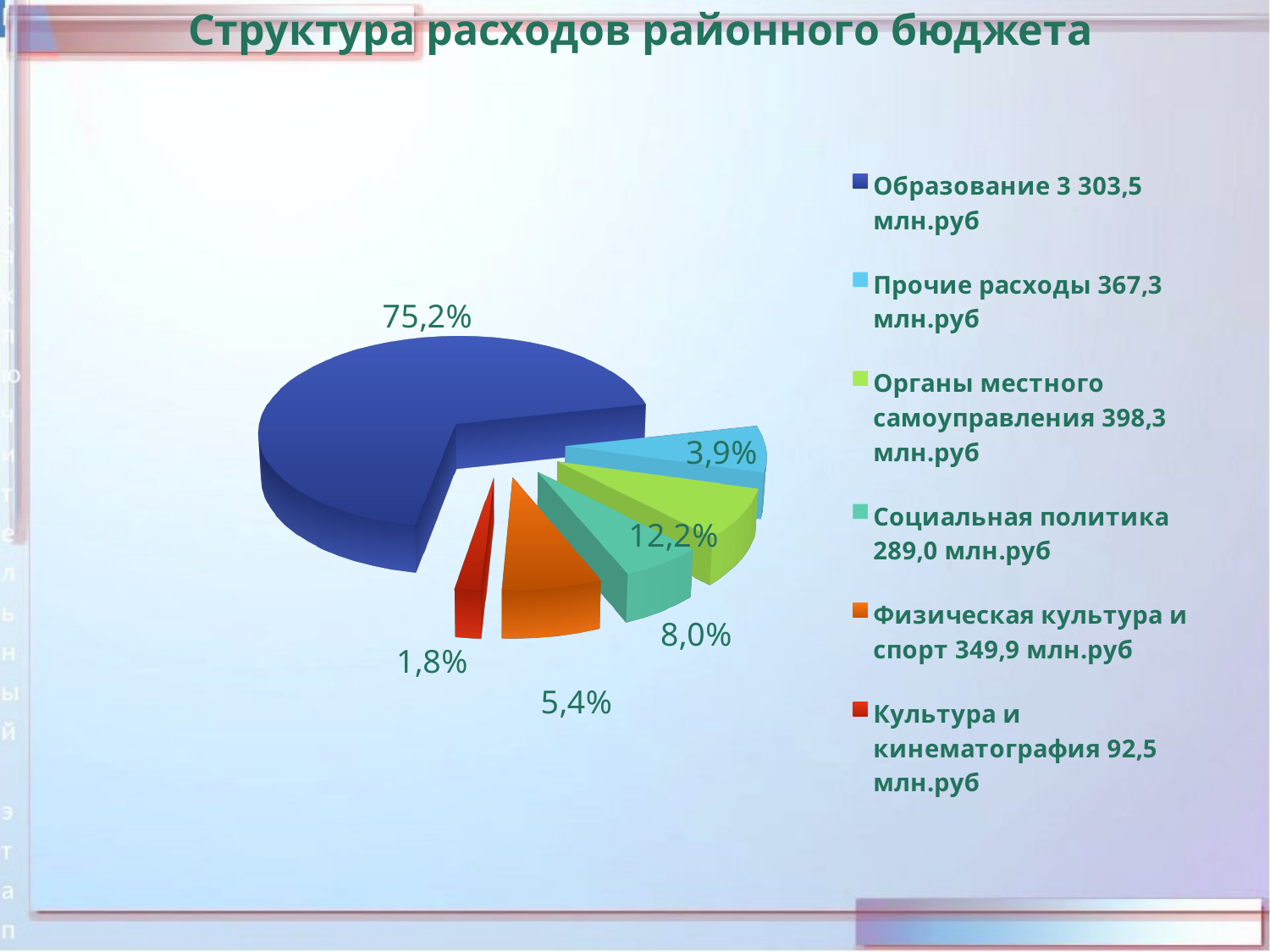
What share of the pie does Образование take? 75,2% Which category has the largest share of the pie? Образование What is the title of the chart? Структура расходов районного бюджета What is the difference in percentage points between the Органы местного самоуправления slice and the Прочие расходы slice? 8,3 What percentage is shown for the Культура и кинематография slice? 1,8% How many slices does the pie chart have? 6 What percentage is shown for the Социальная политика slice? 8,0% What percentage is shown for the Органы местного самоуправления slice? 12,2% What type of chart is shown on the slide? pie chart Which category has the smallest share of the pie? Культура и кинематография What amount in млн.руб does the legend give for Физическая культура и спорт? 349,9 млн.руб